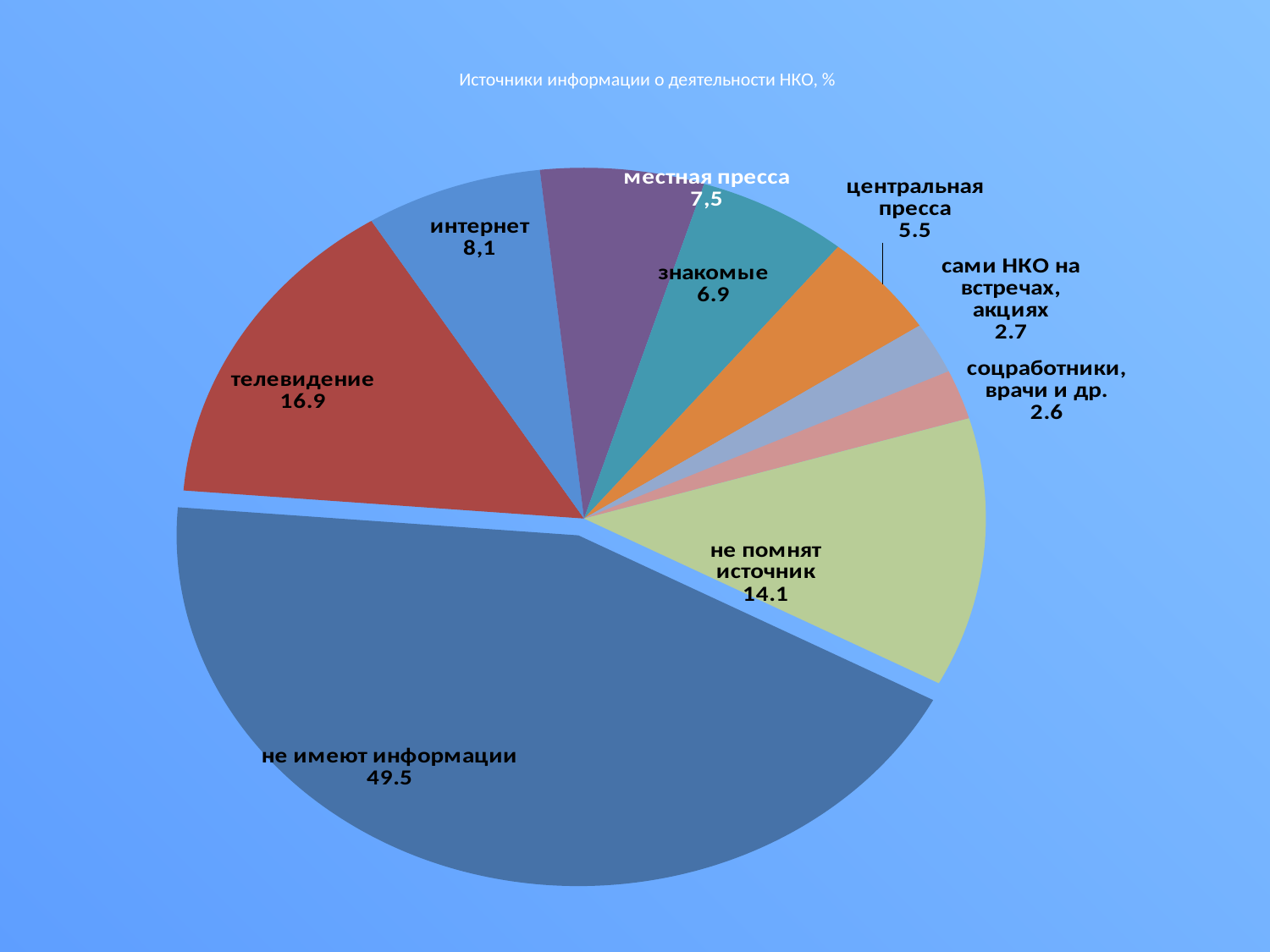
What is the value for центральная пресса? 5.5 What is the value for не помнят источник? 14.1 What is the value for интернет? 8,1 What is the value for телевидение? 16.9 Which category has the smallest slice? соцработники, врачи и др. What type of chart is shown on the slide? pie chart What is the difference between телевидение and не помнят источник? 2.8 What is the difference between не имеют информации and телевидение? 32.6 How many slices does the pie chart have? 9 Which is larger, знакомые or центральная пресса? знакомые Which category has the largest slice? не имеют информации What is the title of the chart? Источники информации о деятельности НКО, %